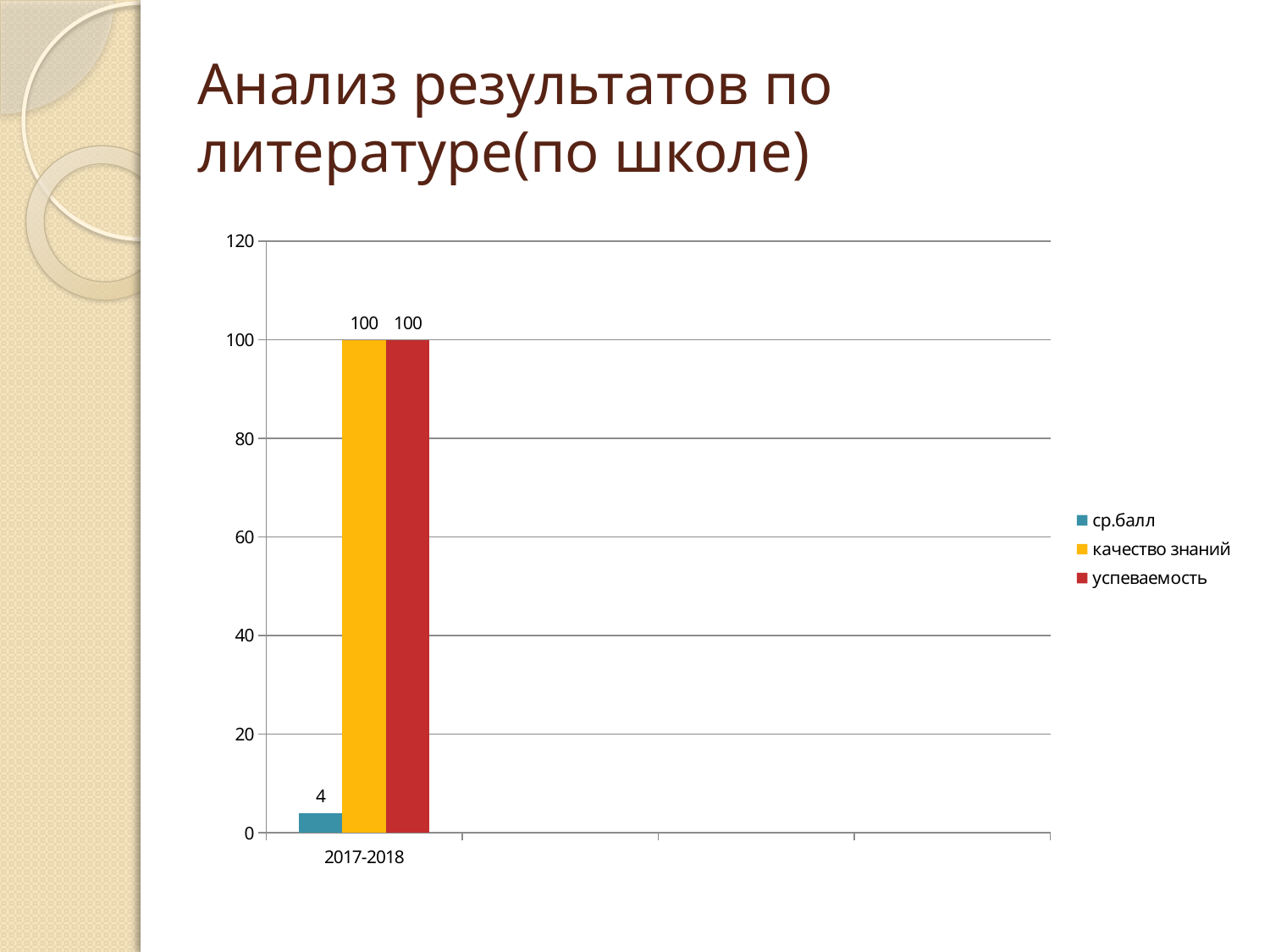
Which is larger for 2017-2018, ср.балл or успеваемость? успеваемость Is the value of ср.балл for 2017-2018 greater or less than 20? less How many categories are shown on the x axis? 1 What is the value of качество знаний for 2017-2018? 100 Which series has the lowest value for 2017-2018? ср.балл What kind of chart is shown on the slide? bar chart What is the value of ср.балл for 2017-2018? 4 What is the value of успеваемость for 2017-2018? 100 How many series does the legend list? 3 What colour is the bar for качество знаний? yellow What is the difference between качество знаний and ср.балл for 2017-2018? 96 Is the value of успеваемость for 2017-2018 greater or less than 80? greater